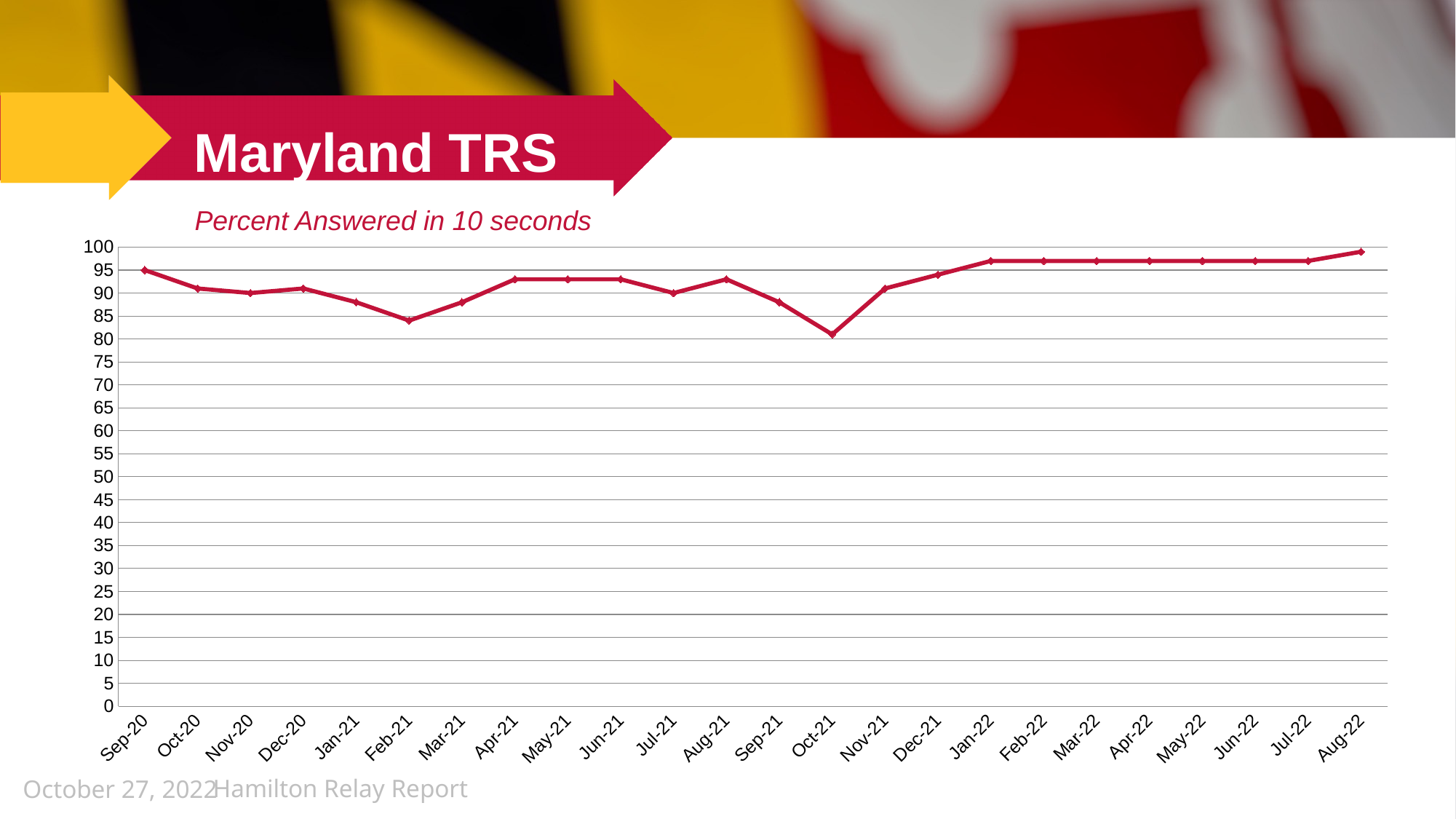
Which is larger, the value for Feb-21 or the value for Oct-21? Feb-21 Is the value for Feb-21 greater or less than 90? less Which month has the highest percent answered in 10 seconds? Aug-22 From Oct-21 to Aug-22, does the percent answered in 10 seconds rise or fall? rise Is the value for Apr-21 greater or less than 90? greater How many months are plotted along the x axis? 24 Which month has the lowest percent answered in 10 seconds? Oct-21 Is the value for Oct-21 greater or less than 85? less Which is larger, the value for Jan-21 or the value for Apr-21? Apr-21 What kind of chart is shown on the slide? line chart What is the title of the chart? Percent Answered in 10 seconds